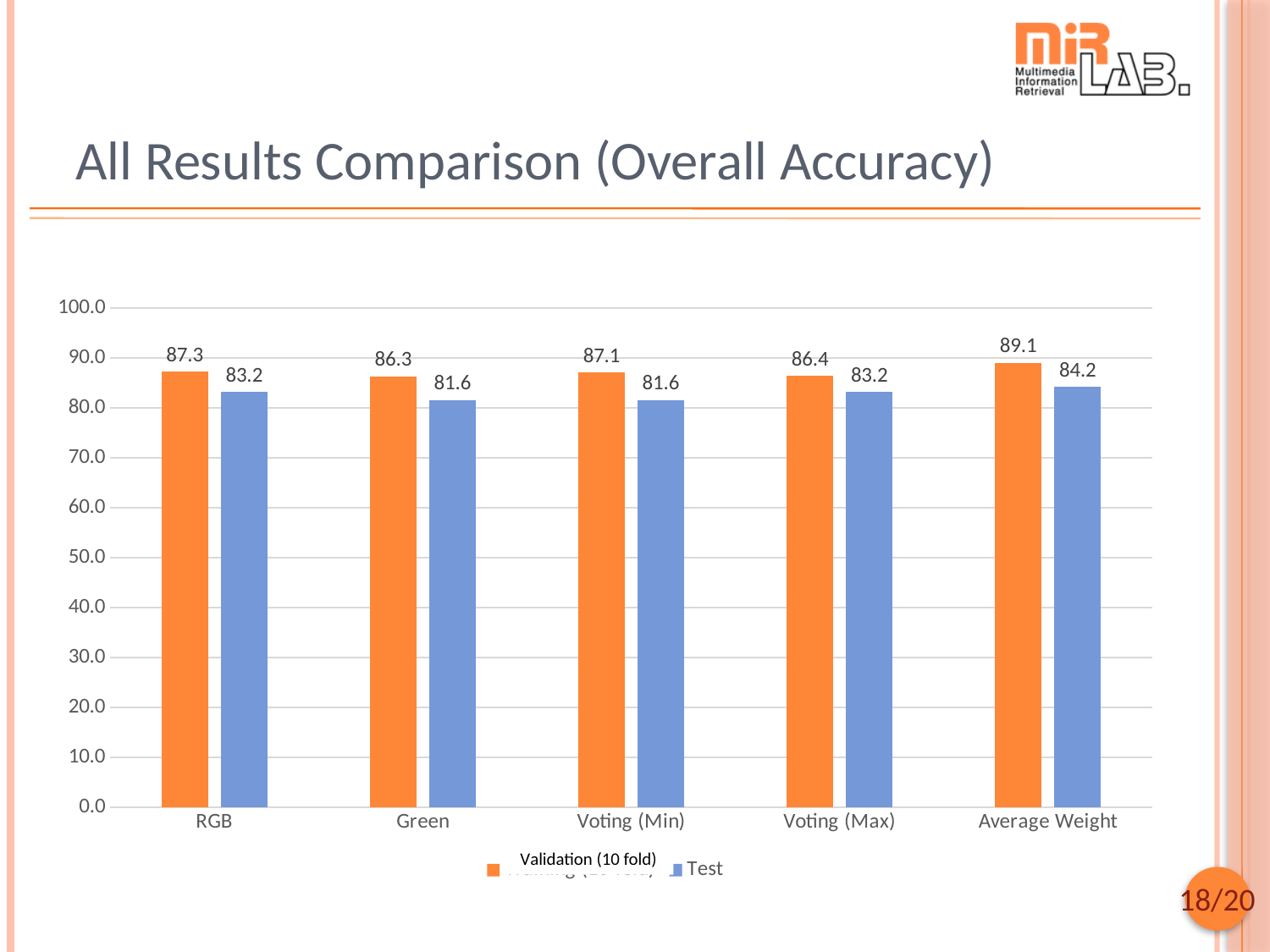
What kind of chart is shown on the slide? bar chart Which category has the highest Test value? Average Weight Which category has the highest Validation (10 fold) value? Average Weight How many series does the legend list? 2 Which is larger, the Test value for Voting (Max) or the Test value for Voting (Min)? Voting (Max) Is the Test value for Average Weight greater or less than 90.0? less What is the difference between the Validation (10 fold) values for Average Weight and Green? 2.8 What is the Validation (10 fold) value for Voting (Min)? 87.1 What is the difference between the Validation (10 fold) and Test values for RGB? 4.1 What is the Validation (10 fold) value for Average Weight? 89.1 How many categories are shown on the x axis? 5 What is the Test value for Green? 81.6